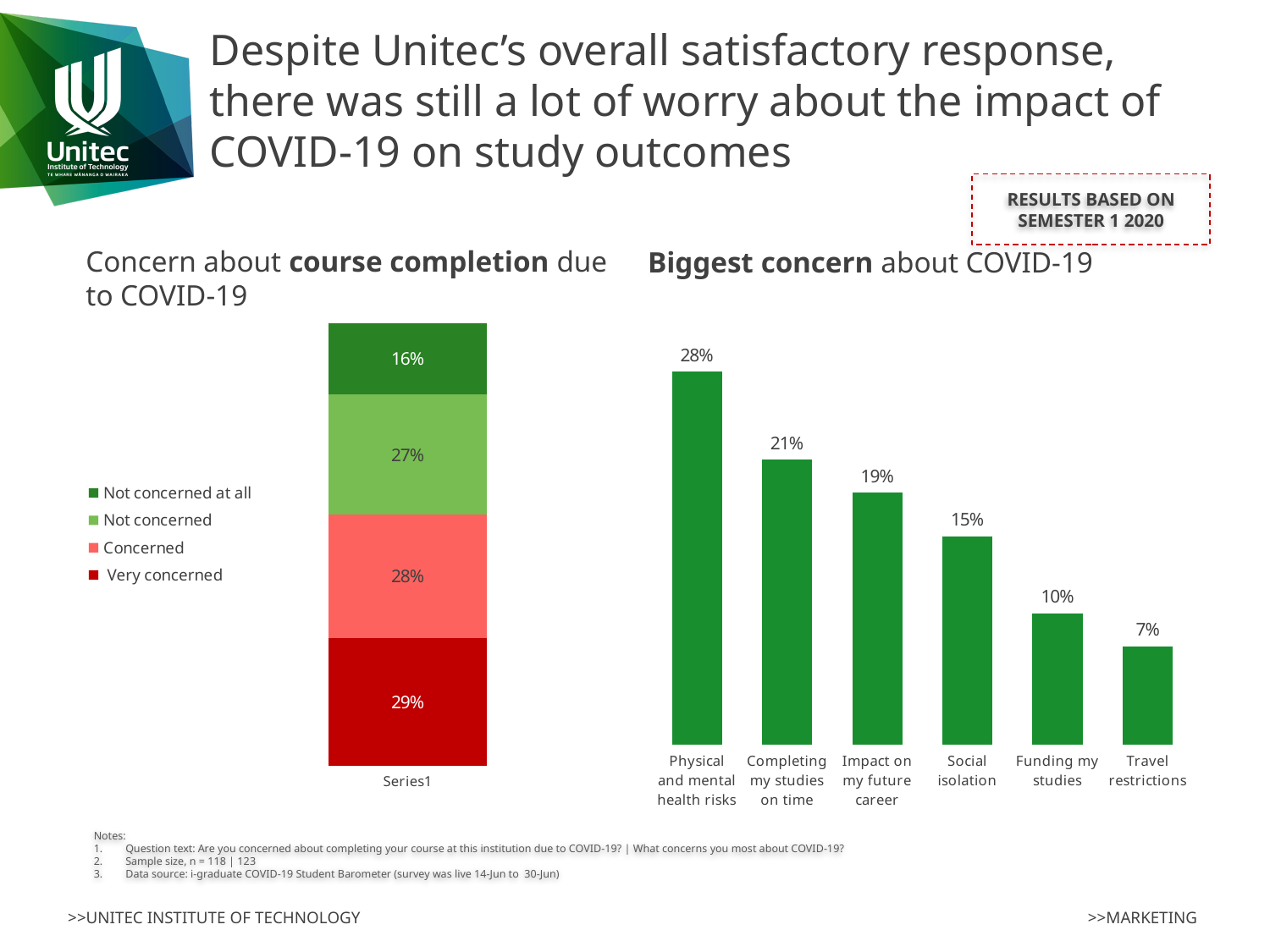
In the 'Concern about course completion due to COVID-19' chart, what percentage of respondents were 'Not concerned at all'? 16% In the 'Biggest concern about COVID-19' chart, what is the difference between 'Completing my studies on time' and 'Funding my studies'? 11% In the 'Biggest concern about COVID-19' chart, which concern has the lowest percentage? Travel restrictions In the 'Biggest concern about COVID-19' chart, which concern has the highest percentage? Physical and mental health risks In the 'Concern about course completion due to COVID-19' chart, what is the combined percentage of 'Concerned' and 'Very concerned' respondents? 57% In the 'Biggest concern about COVID-19' chart, how many concern categories are shown? 6 In the 'Concern about course completion due to COVID-19' chart, what percentage of respondents were 'Very concerned'? 29% In the 'Biggest concern about COVID-19' chart, what percentage chose 'Social isolation'? 15% In the 'Biggest concern about COVID-19' chart, do the values rise or fall from left to right? fall In the 'Concern about course completion due to COVID-19' chart, which response category has the smallest share? Not concerned at all In the 'Biggest concern about COVID-19' chart, what percentage chose 'Physical and mental health risks'? 28% In the 'Concern about course completion due to COVID-19' chart, how many series does the legend list? 4